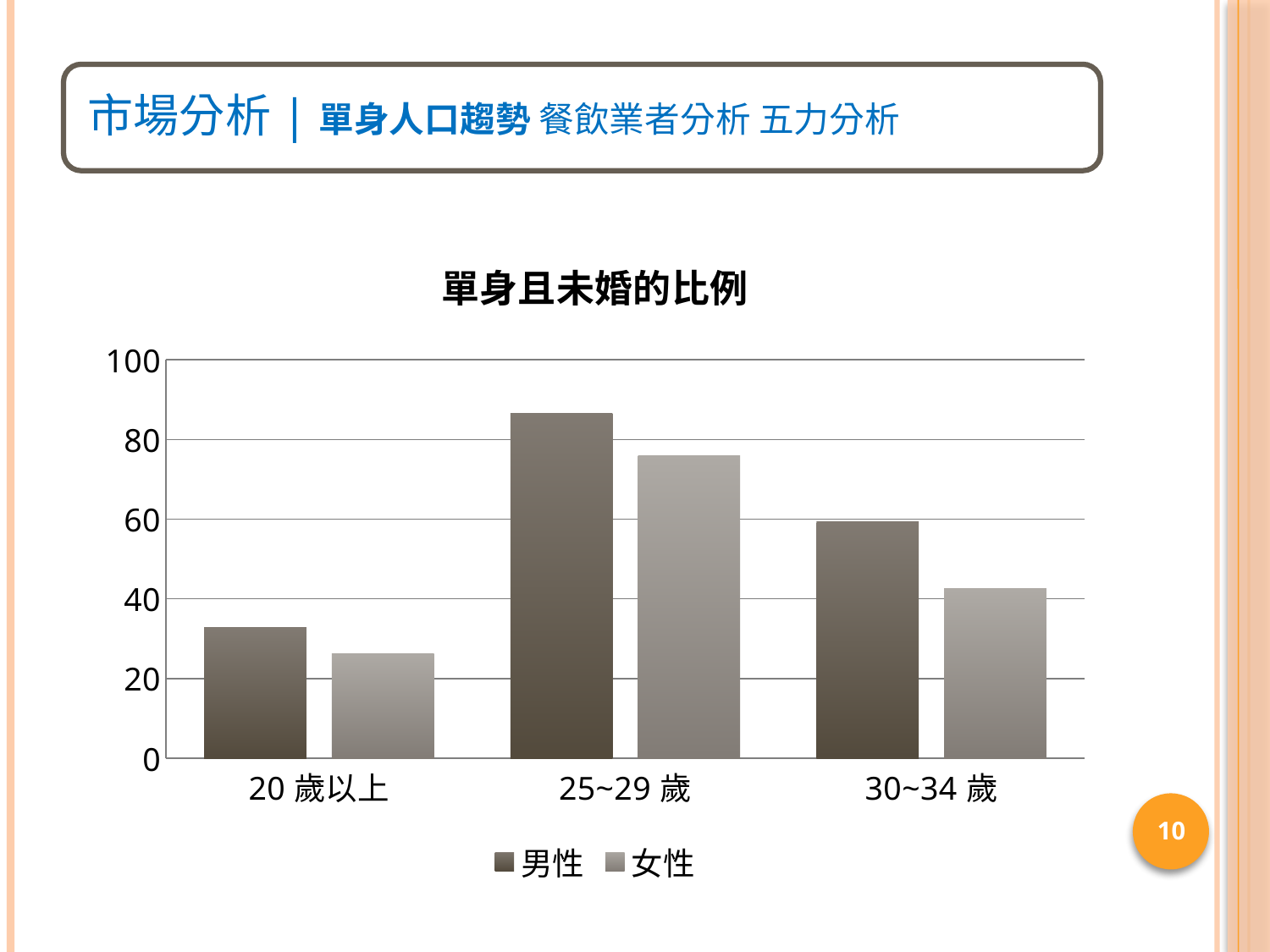
In the 25~29 歲 category, which is larger, 男性 or 女性? 男性 Is the value for 男性 in the 20 歲以上 category greater or less than 40? less Is the value for 女性 in the 25~29 歲 category greater or less than 60? greater Is the value for 男性 in the 25~29 歲 category greater or less than 80? greater How many series does the legend list? 2 Which age category has the highest value for 男性? 25~29 歲 How many age categories are shown on the x axis? 3 What is the title of the chart? 單身且未婚的比例 Which age category has the lowest value for 女性? 20 歲以上 What are the two series named in the legend? 男性 and 女性 What kind of chart is shown on the slide? bar chart